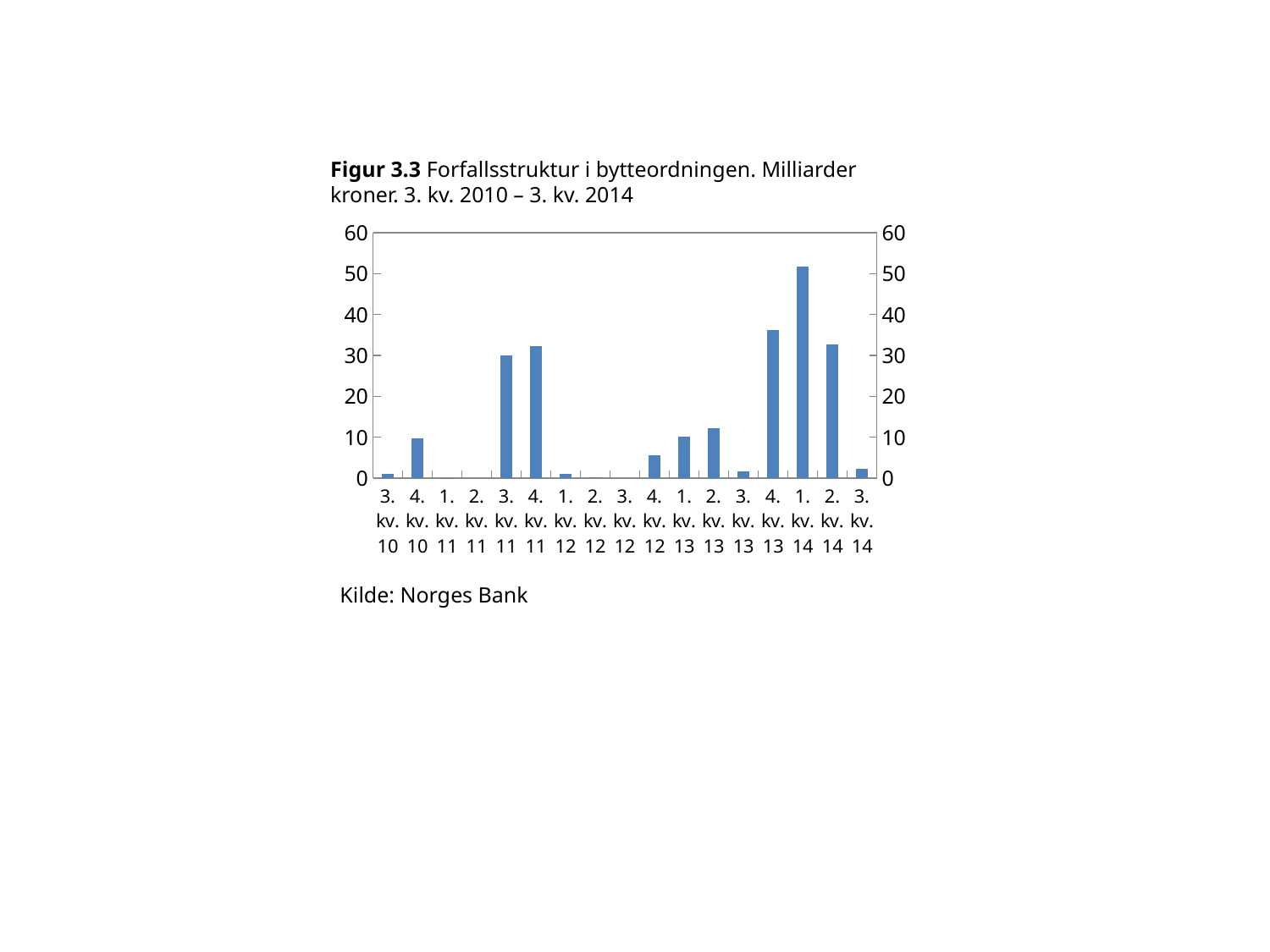
What kind of chart is shown on the slide? bar chart Is the value for 4. kv. 10 greater or less than 20? less Which is larger, the value for 4. kv. 13 or the value for 3. kv. 11? 4. kv. 13 Is the value for 4. kv. 13 greater or less than 40? less Is the value for 1. kv. 14 greater or less than 50? greater Which is larger, the value for 1. kv. 14 or the value for 2. kv. 14? 1. kv. 14 What source is cited below the chart? Norges Bank Which quarter has the highest value in the chart? 1. kv. 14 How many quarters (categories) are shown on the x axis? 17 What is the figure number given in the chart title? Figur 3.3